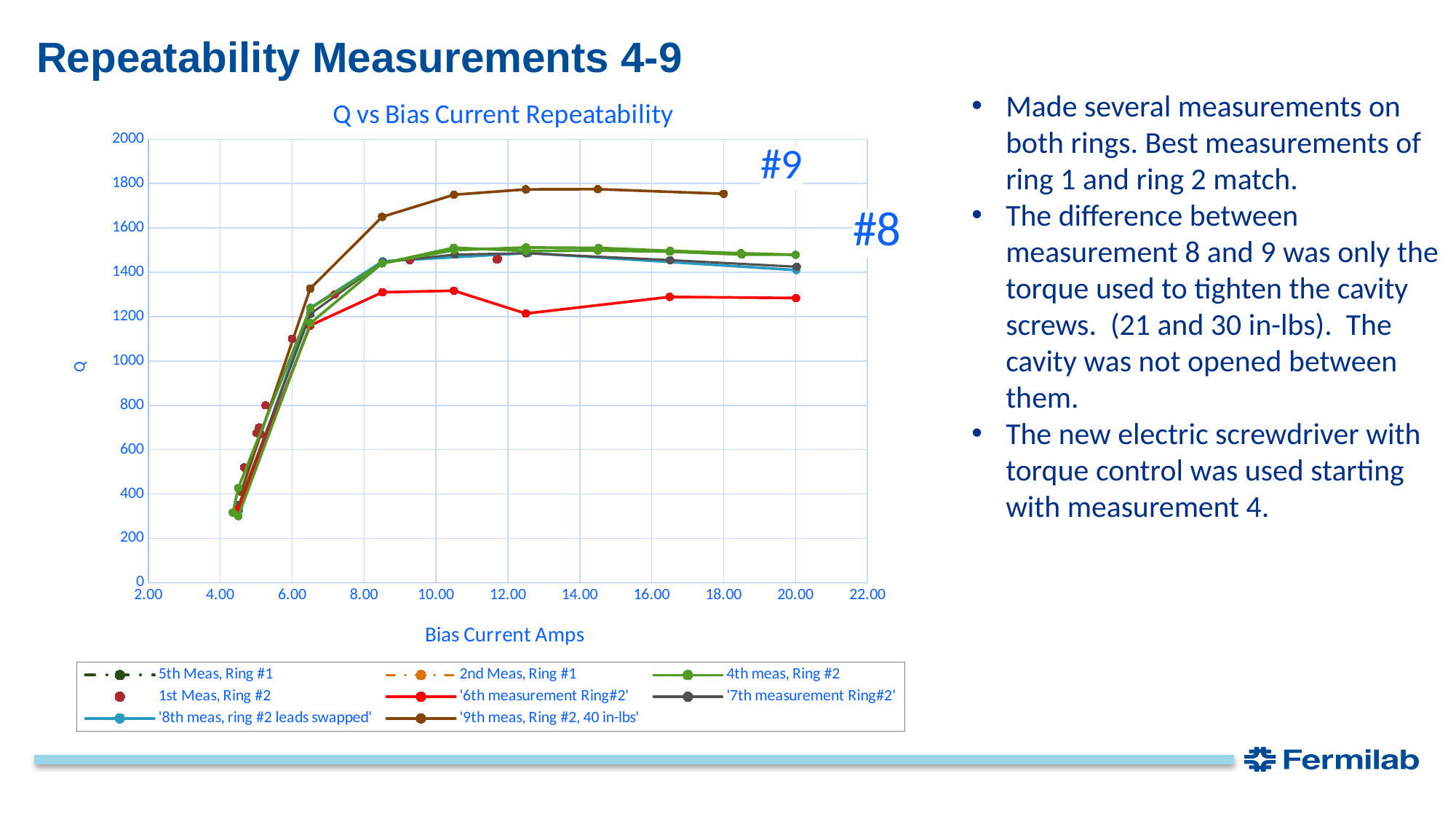
How many series does the legend of the chart list? 8 What is the title of the chart? Q vs Bias Current Repeatability What kind of chart is shown on the slide? line chart Is the value of the '6th measurement Ring#2' series at a bias current of 20.00 amps greater or less than 1400? less What is the label of the x axis of the chart? Bias Current Amps Is the value of the '9th meas, Ring #2, 40 in-lbs' series at a bias current of 12.50 amps greater or less than 1600? greater Which series has the lowest Q at a bias current of 12.50 amps? '6th measurement Ring#2' Is the value of the '6th measurement Ring#2' series at a bias current of 12.50 amps greater or less than 1400? less Does Q rise or fall as the bias current increases from about 4 amps to 8 amps? rise Which series has the highest Q at a bias current of 18.00 amps? '9th meas, Ring #2, 40 in-lbs' At a bias current of 12.50 amps, which is larger: the '9th meas, Ring #2, 40 in-lbs' value or the '6th measurement Ring#2' value? '9th meas, Ring #2, 40 in-lbs'